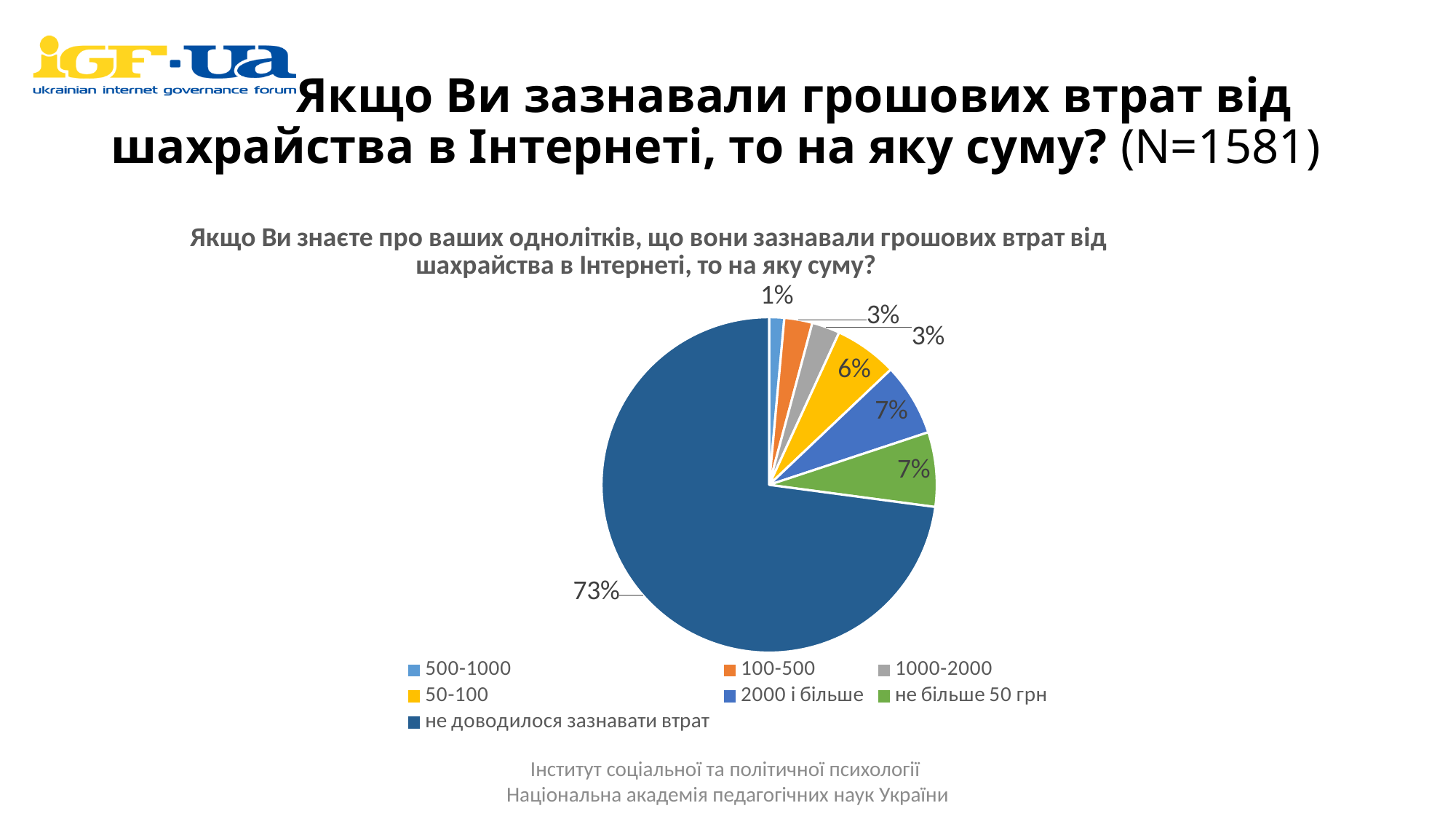
What colour is the slice for "не більше 50 грн"? green What share of the pie is labelled "не більше 50 грн"? 7% Which category has the largest slice of the pie? не доводилося зазнавати втрат How many slices does the pie chart have? 7 What is the difference between the share for "не доводилося зазнавати втрат" and the share for "50-100"? 67% Which is larger, the share for "50-100" or the share for "100-500"? 50-100 What kind of chart is shown on the slide? pie chart What share of the pie is labelled "2000 і більше"? 7% Which category has the smallest slice of the pie? 500-1000 What share of the pie is labelled "не доводилося зазнавати втрат"? 73% What share of the pie is labelled "50-100"? 6% What share of the pie is labelled "500-1000"? 1%